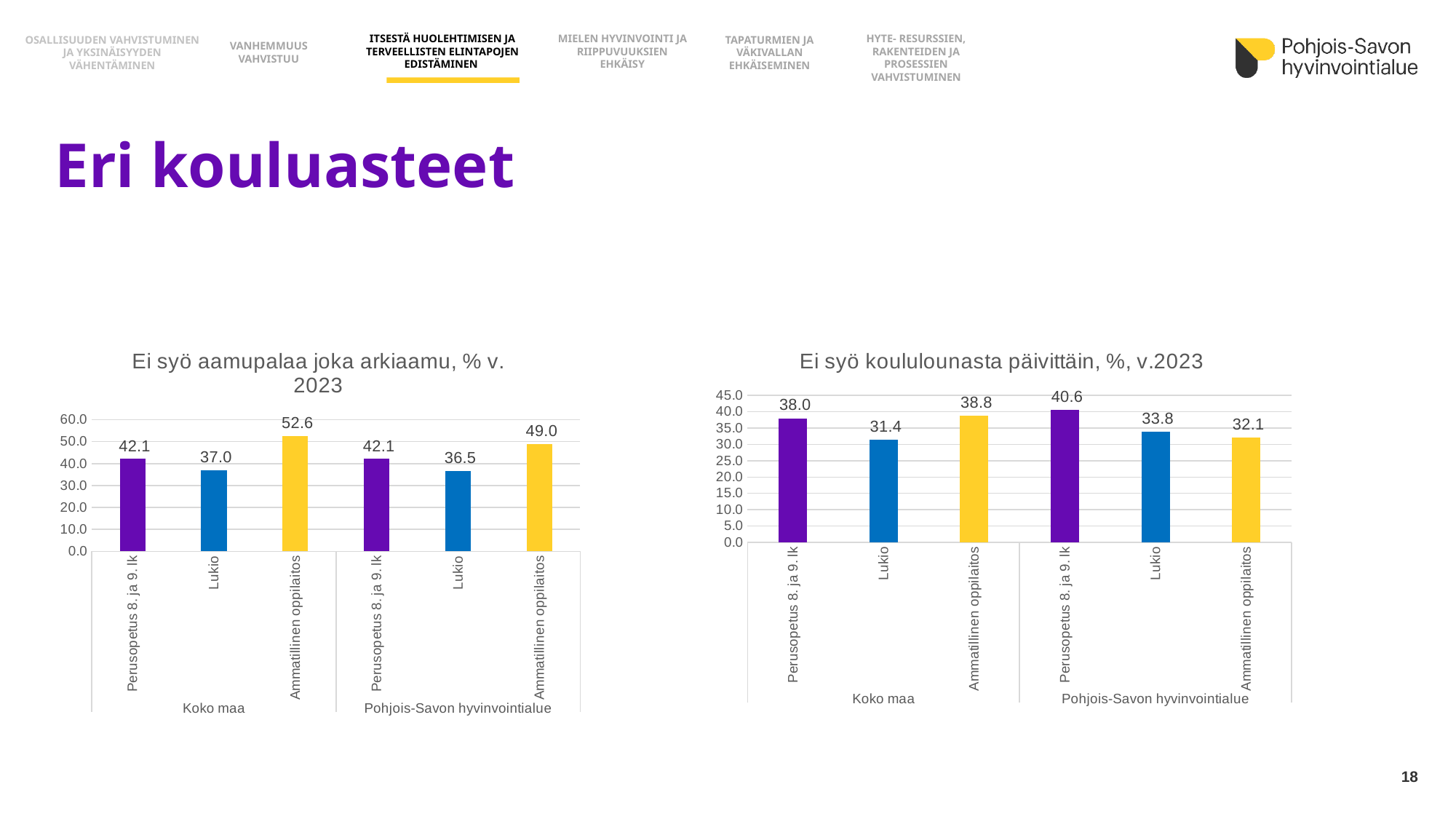
In the chart 'Ei syö koululounasta päivittäin, %, v.2023', what is the value for Lukio in Koko maa? 31.4 What type of chart is the left chart on the slide? Bar chart In the chart 'Ei syö aamupalaa joka arkiaamu, % v. 2023', which bar has the lowest value? Lukio, Pohjois-Savon hyvinvointialue In the chart 'Ei syö aamupalaa joka arkiaamu, % v. 2023', what is the value for Lukio in Pohjois-Savon hyvinvointialue? 36.5 In the chart 'Ei syö aamupalaa joka arkiaamu, % v. 2023', what is the difference between Ammatillinen oppilaitos in Koko maa and Ammatillinen oppilaitos in Pohjois-Savon hyvinvointialue? 3.6 In the chart 'Ei syö aamupalaa joka arkiaamu, % v. 2023', what is the value for Ammatillinen oppilaitos in Koko maa? 52.6 How many bars are plotted in the chart 'Ei syö koululounasta päivittäin, %, v.2023'? 6 In the chart 'Ei syö koululounasta päivittäin, %, v.2023', which bar has the highest value? Perusopetus 8. ja 9. lk, Pohjois-Savon hyvinvointialue In the chart 'Ei syö koululounasta päivittäin, %, v.2023', what is the difference between Lukio in Pohjois-Savon hyvinvointialue and Lukio in Koko maa? 2.4 In the chart 'Ei syö koululounasta päivittäin, %, v.2023', what is the value for Perusopetus 8. ja 9. lk in Pohjois-Savon hyvinvointialue? 40.6 In the chart 'Ei syö koululounasta päivittäin, %, v.2023', which is larger: Ammatillinen oppilaitos in Koko maa or Ammatillinen oppilaitos in Pohjois-Savon hyvinvointialue? Ammatillinen oppilaitos in Koko maa In the chart 'Ei syö aamupalaa joka arkiaamu, % v. 2023', which bar has the highest value? Ammatillinen oppilaitos, Koko maa